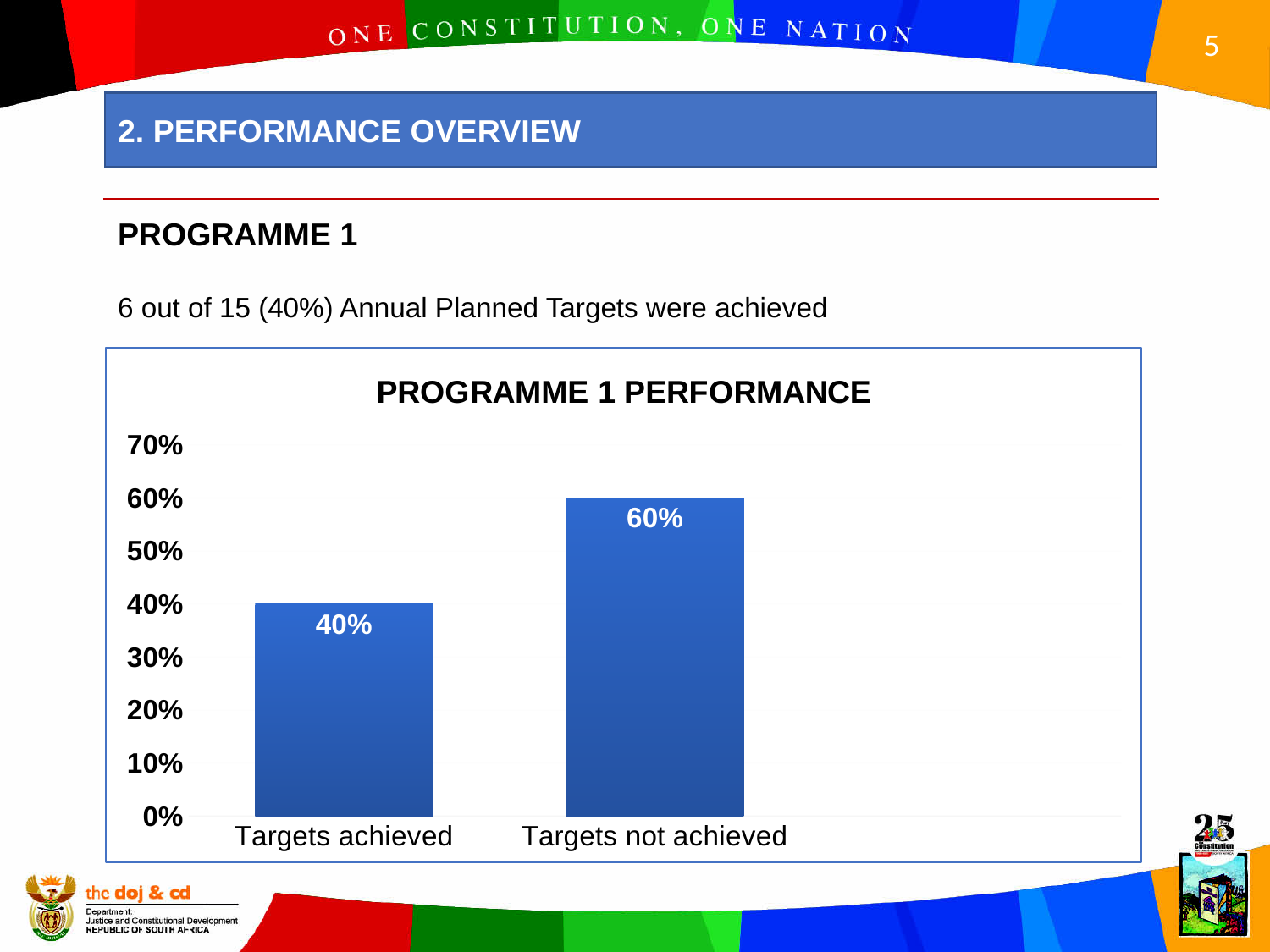
Which category has the highest value? Targets not achieved Which is larger, Targets achieved or Targets not achieved? Targets not achieved Is the value for Targets achieved greater or less than 50%? less What is the title of the chart? PROGRAMME 1 PERFORMANCE What is the value for Targets not achieved? 60% What is the highest value shown on the vertical axis? 70% Is the value for Targets not achieved greater or less than 50%? greater What is the value for Targets achieved? 40% Which category has the lowest value? Targets achieved What kind of chart is shown? bar chart What is the difference between Targets not achieved and Targets achieved? 20% How many categories are shown in the chart? 2